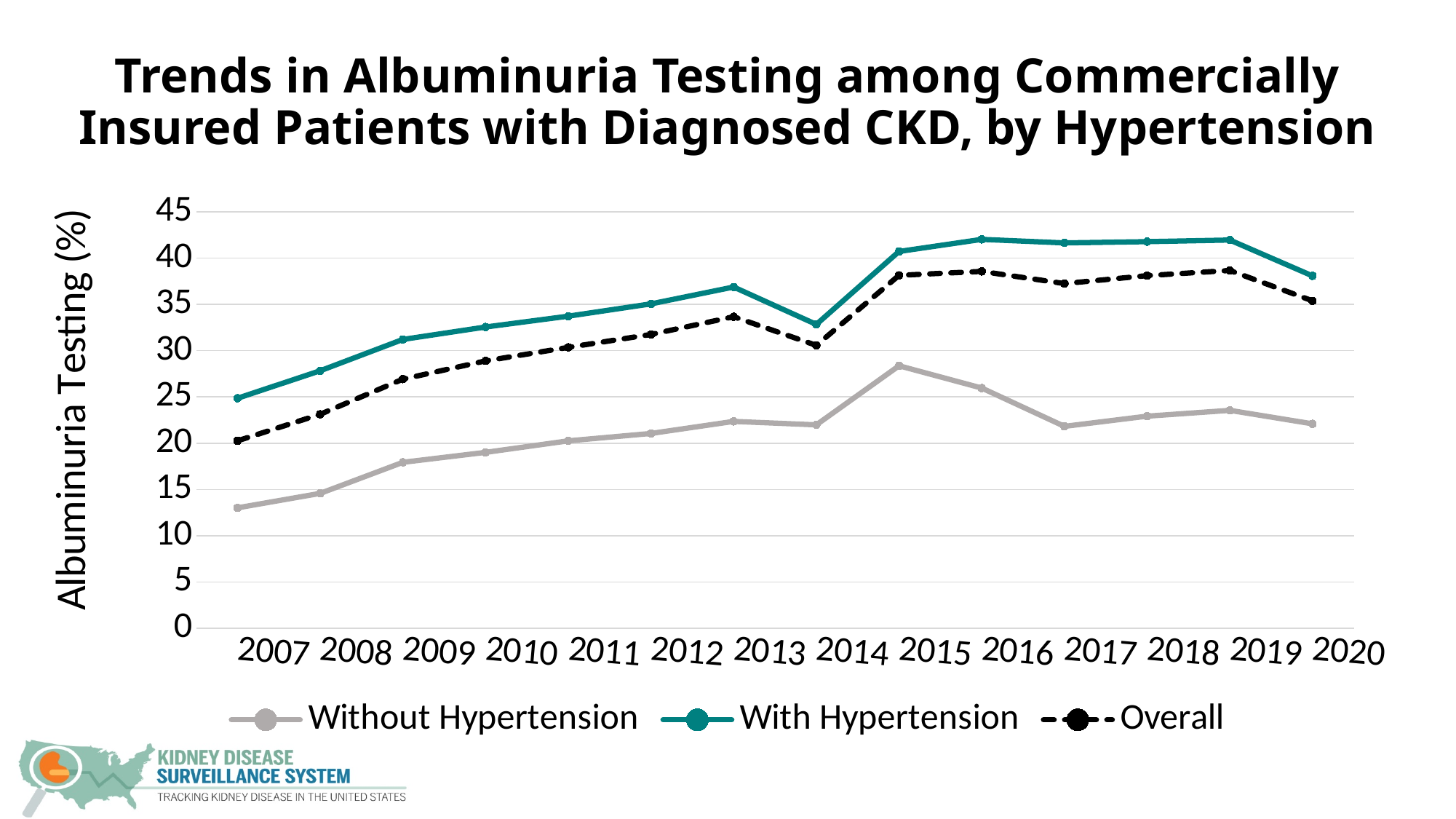
Is the value for Overall in 2014 greater or less than 35? less Is the value for With Hypertension in 2016 greater or less than 40? greater Which series is drawn with a dashed line? Overall In which year is the Without Hypertension series at its lowest? 2007 How many series does the legend list? 3 What kind of chart is shown on the slide? line chart For Without Hypertension, which is larger: the value in 2015 or the value in 2016? 2015 Which series has the highest value in 2015? With Hypertension How many years are plotted along the x axis? 14 Is the value for Without Hypertension in 2007 greater or less than 15? less Does the Without Hypertension series rise or fall from 2007 to 2012? rise